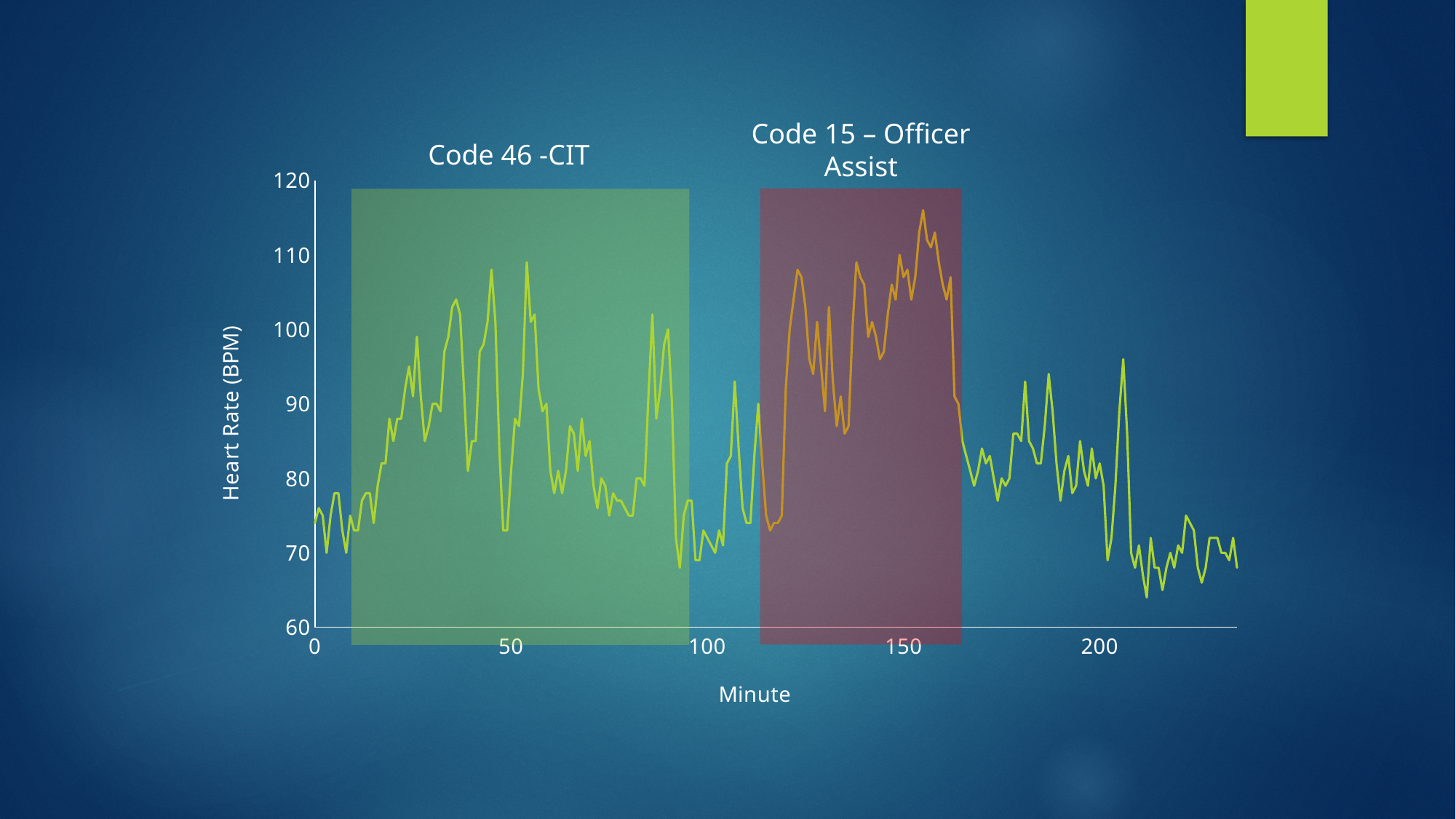
Is the peak heart rate within the Code 46 -CIT region greater or less than 100? greater What is the label of the y axis? Heart Rate (BPM) What kind of chart is shown on the slide? line chart Is the peak heart rate within the Code 15 – Officer Assist region greater or less than 110? greater Does the heart rate generally rise or fall between minute 200 and the end of the chart? fall Is the lowest heart rate on the chart greater or less than 70? less What is the label of the x axis? Minute Does the heart rate generally rise or fall between minute 0 and minute 50? rise Which shaded region contains the higher peak heart rate, Code 46 -CIT or Code 15 – Officer Assist? Code 15 – Officer Assist